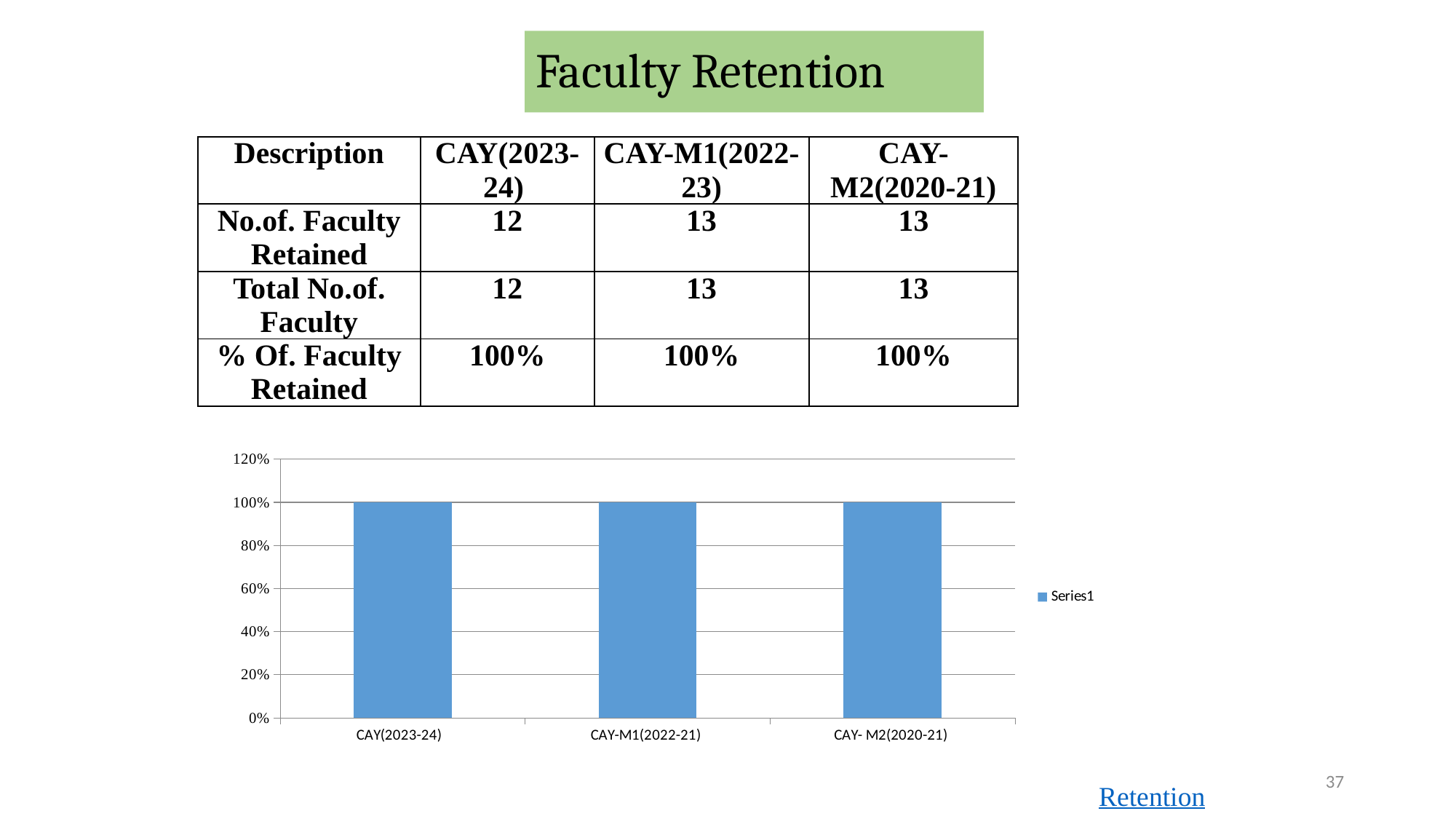
What is the highest value shown on the chart's vertical axis? 120% Is the value for CAY(2023-24) greater or less than 80%? greater What is the value of the bar for CAY- M2(2020-21)? 100% What is the value of the bar for CAY(2023-24)? 100% Do the bar values rise, fall, or stay the same across the categories from left to right? stay the same What type of chart is shown on the slide? bar chart How many series does the chart legend list? 1 Is the value for CAY- M2(2020-21) greater or less than 120%? less What is the value of the bar for CAY-M1(2022-21)? 100% What is the name of the series shown in the chart legend? Series1 How many categories are shown on the x axis of the chart? 3 What is the difference between the values for CAY(2023-24) and CAY-M1(2022-21)? 0%